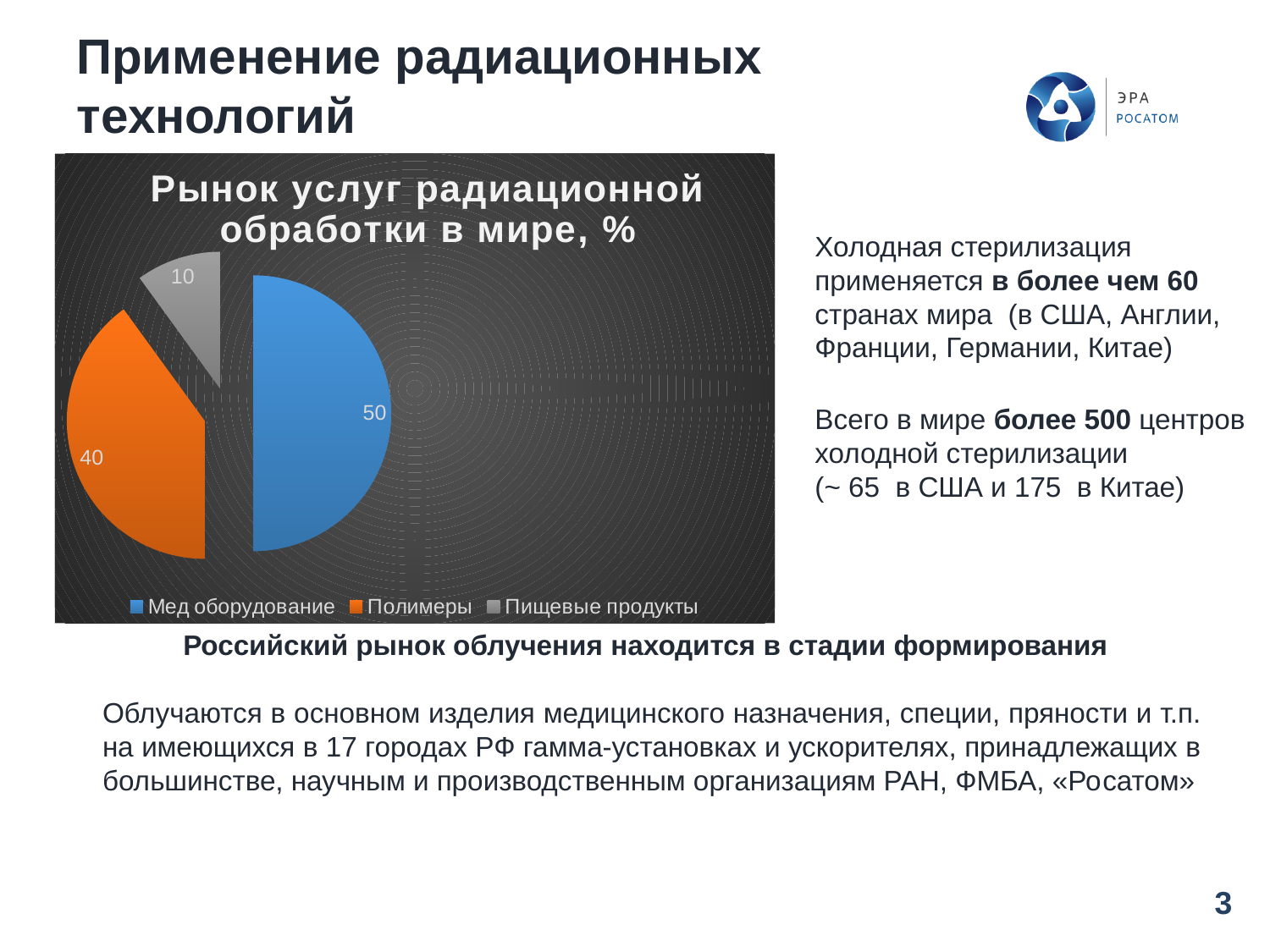
Which is larger, the value for Полимеры or the value for Пищевые продукты? Полимеры What is the value for Полимеры in the pie chart? 40 What is the difference between the values for Мед оборудование and Полимеры? 10 What colour is the slice for Полимеры? Orange What type of chart is shown on the slide? Pie chart What is the value for Пищевые продукты in the pie chart? 10 What is the value for Мед оборудование in the pie chart? 50 What is the title of the pie chart? Рынок услуг радиационной обработки в мире, % Which category has the largest share of the pie chart? Мед оборудование Which category has the smallest share of the pie chart? Пищевые продукты How many categories does the pie chart show? 3 What is the difference between the values for Полимеры and Пищевые продукты? 30